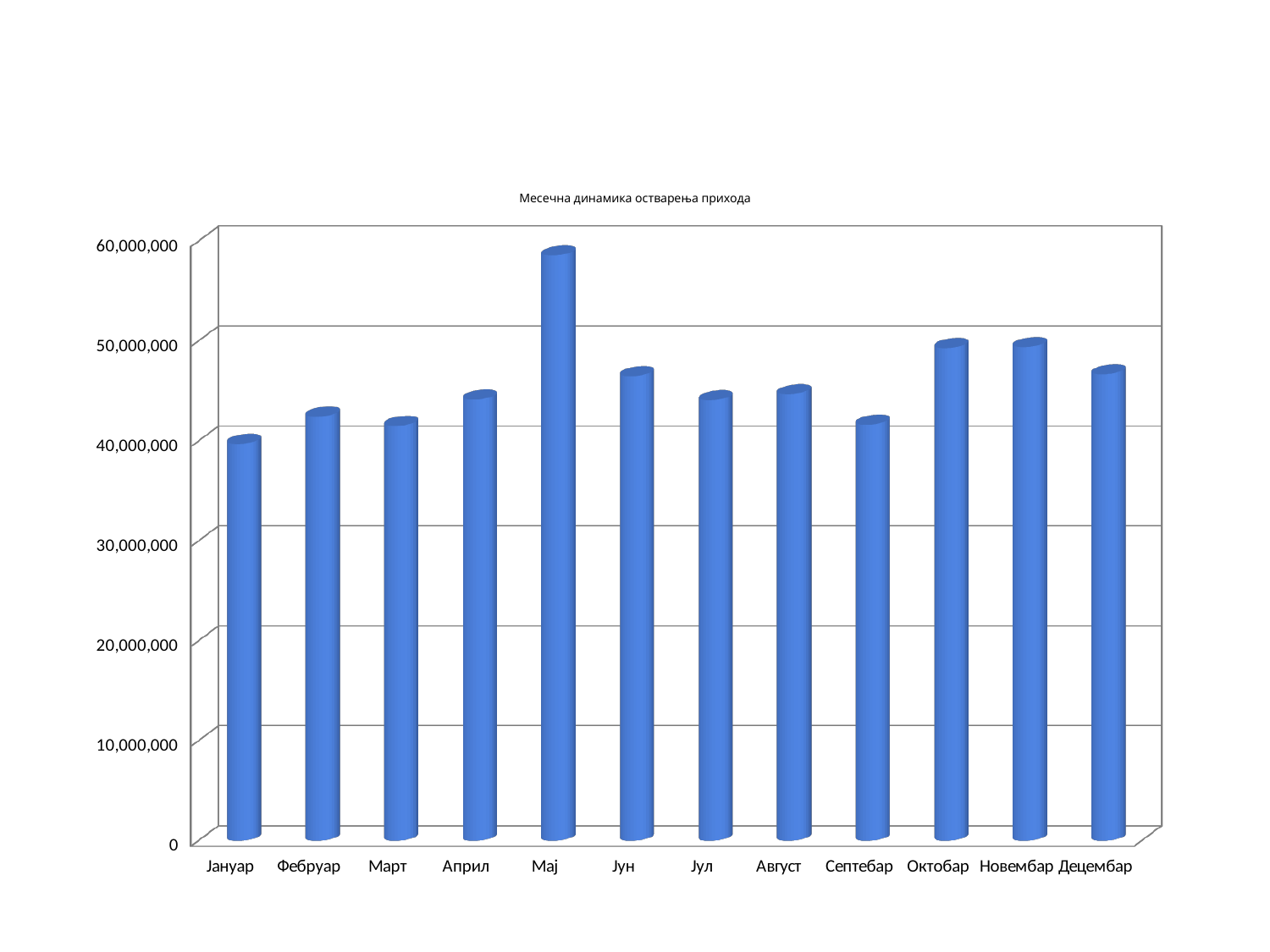
Is the value for Јун greater or less than 40,000,000? greater Which month has the highest bar? Мај What kind of chart is shown on the slide? Bar chart What is the title of the chart? Месечна динамика остварења прихода Which is larger, the value for Октобар or the value for Јануар? Октобар What is the highest value shown on the vertical axis? 60,000,000 Is the value for Април greater or less than 30,000,000? greater Is the value for Септебар greater or less than 50,000,000? less Which is larger, the value for Мај or the value for Јун? Мај How many months (categories) are plotted on the x axis? 12